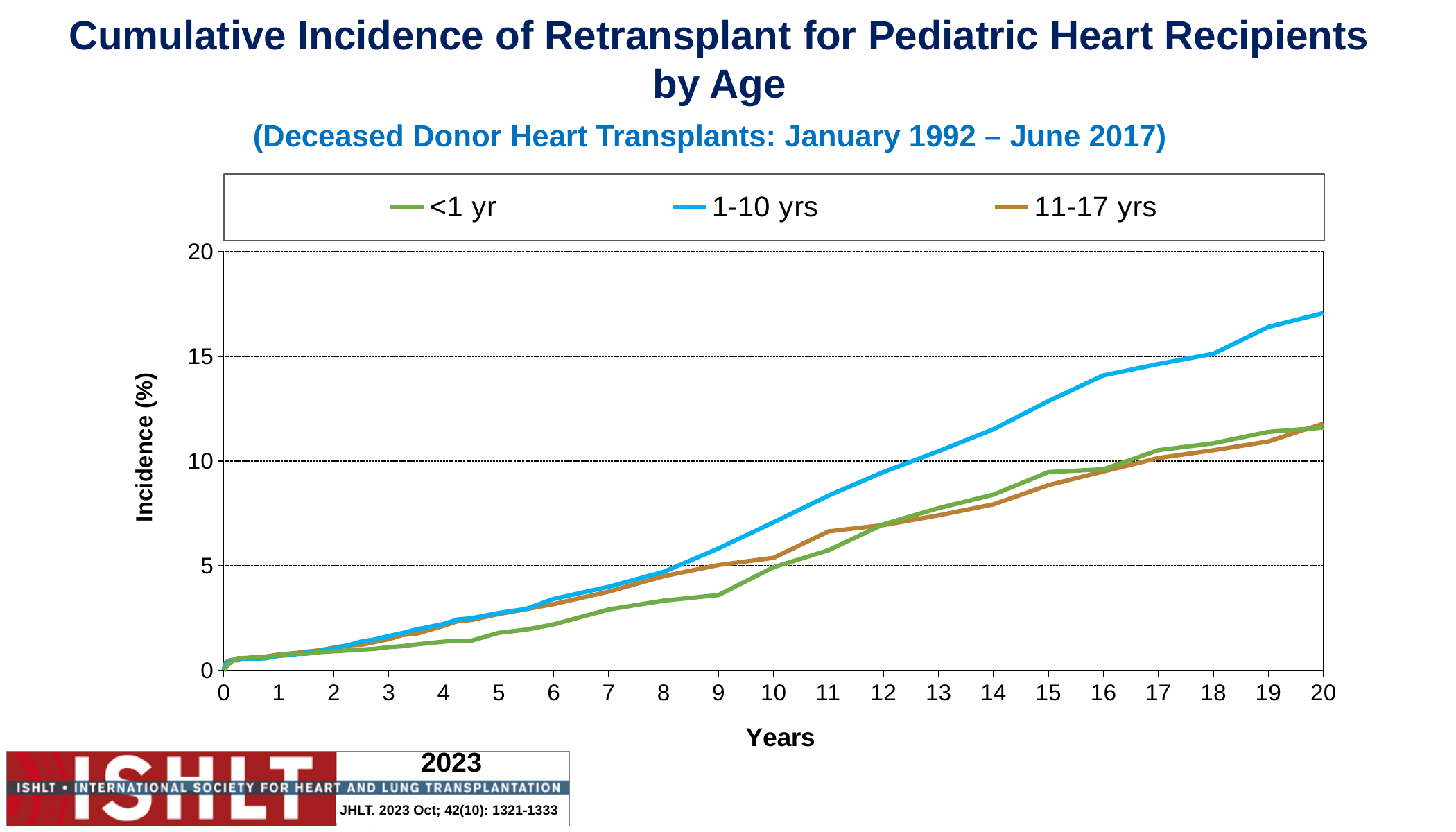
What kind of chart is shown on the slide? line chart Which age group has the lowest cumulative incidence of retransplant at 9 years? <1 yr What colour is the line for the 11-17 yrs group? brown Is the value for the 11-17 yrs group at 15 years greater or less than 10? less At 20 years, which group has the higher incidence: 1-10 yrs or <1 yr? 1-10 yrs What is the label of the y axis? Incidence (%) How many series does the legend list? 3 Is the value for the 1-10 yrs group at 20 years greater or less than 15? greater Do the incidence values rise or fall as the number of years increases? rise Which age group has the highest cumulative incidence of retransplant at 20 years? 1-10 yrs Is the value for the 1-10 yrs group at 16 years greater or less than 15? less